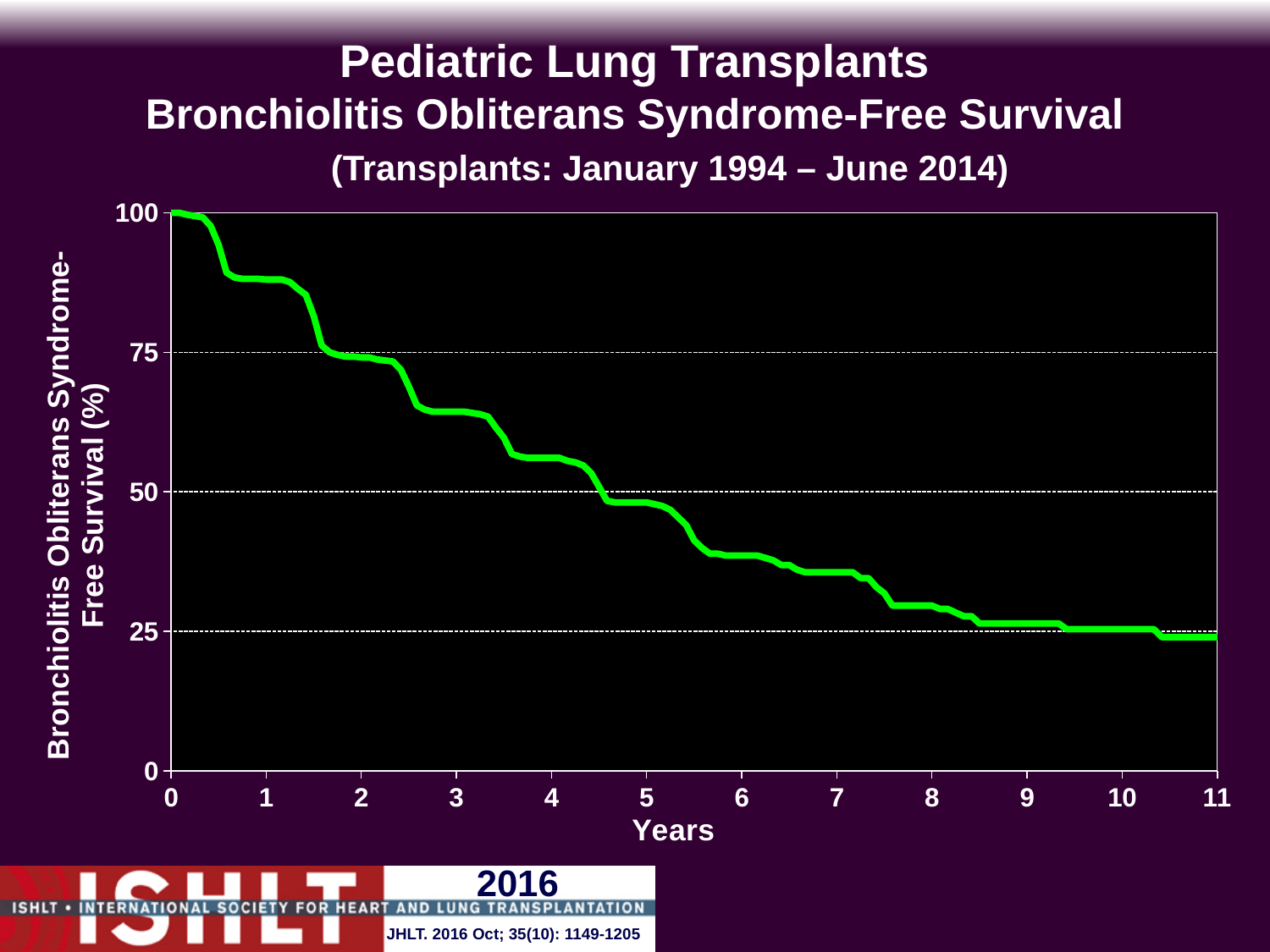
Is the survival value at 1 year greater or less than 75? greater What is the label of the x axis? Years What kind of chart is shown on the slide? line chart What transplant period does the chart cover, according to the title? January 1994 – June 2014 Is the survival value at 8 years greater or less than 25? greater Is the survival value at 6 years greater or less than 25? greater Does the Bronchiolitis Obliterans Syndrome-free survival rise or fall as years increase? fall